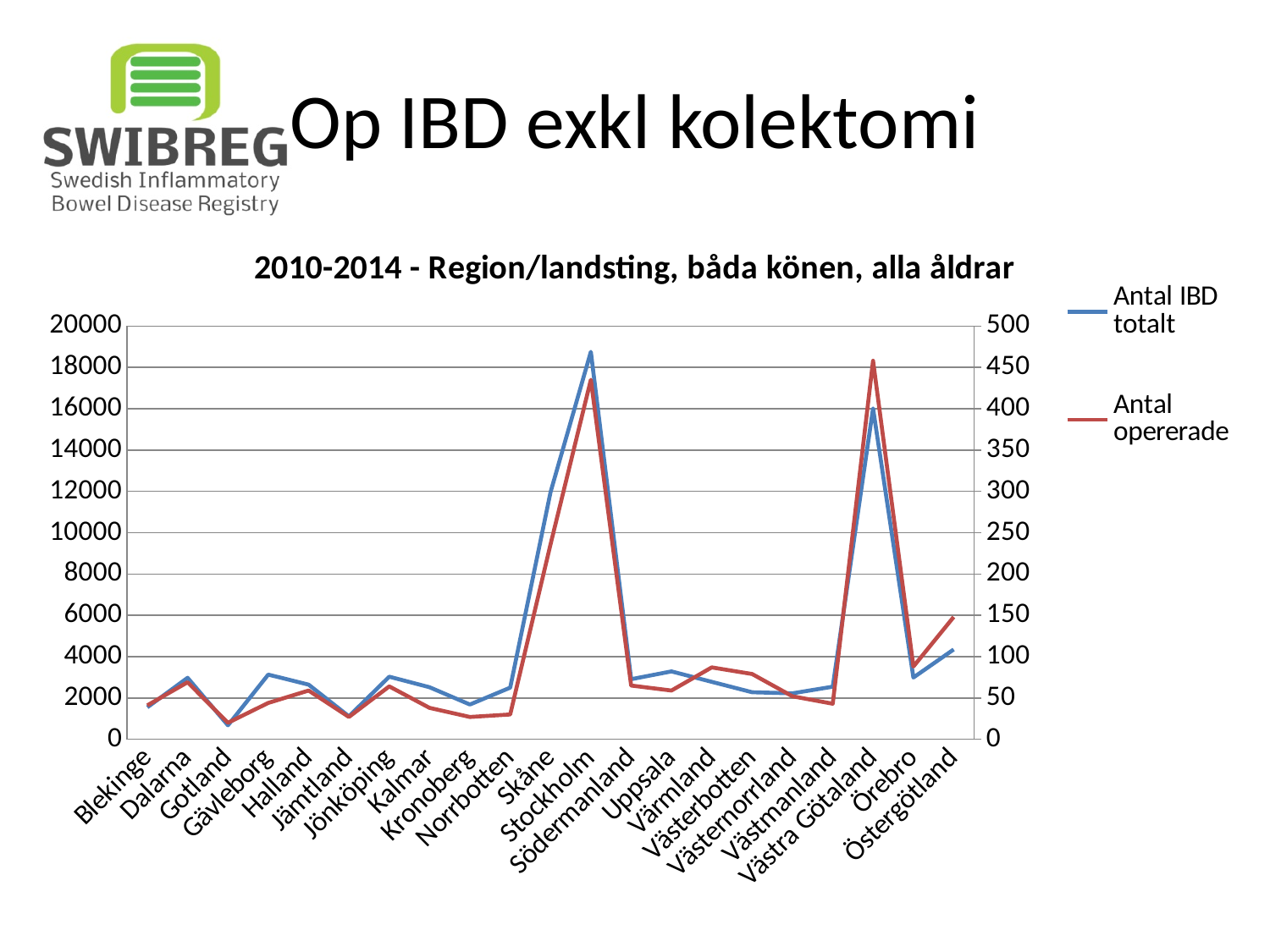
How many regions are shown along the x axis? 21 Which colour is used for the Antal opererade series? red Which has the larger value for Antal IBD totalt, Stockholm or Västra Götaland? Stockholm Which region has the lowest value for Antal IBD totalt? Gotland Is the value of Antal opererade for Västra Götaland greater or less than 400? greater Is the value of Antal IBD totalt for Stockholm greater or less than 16000? greater Is the value of Antal IBD totalt for Gotland greater or less than 2000? less Which region has the highest value for Antal IBD totalt? Stockholm How many series does the legend list? 2 What kind of chart is shown on the slide? line chart What is the title of the chart? 2010-2014 - Region/landsting, båda könen, alla åldrar